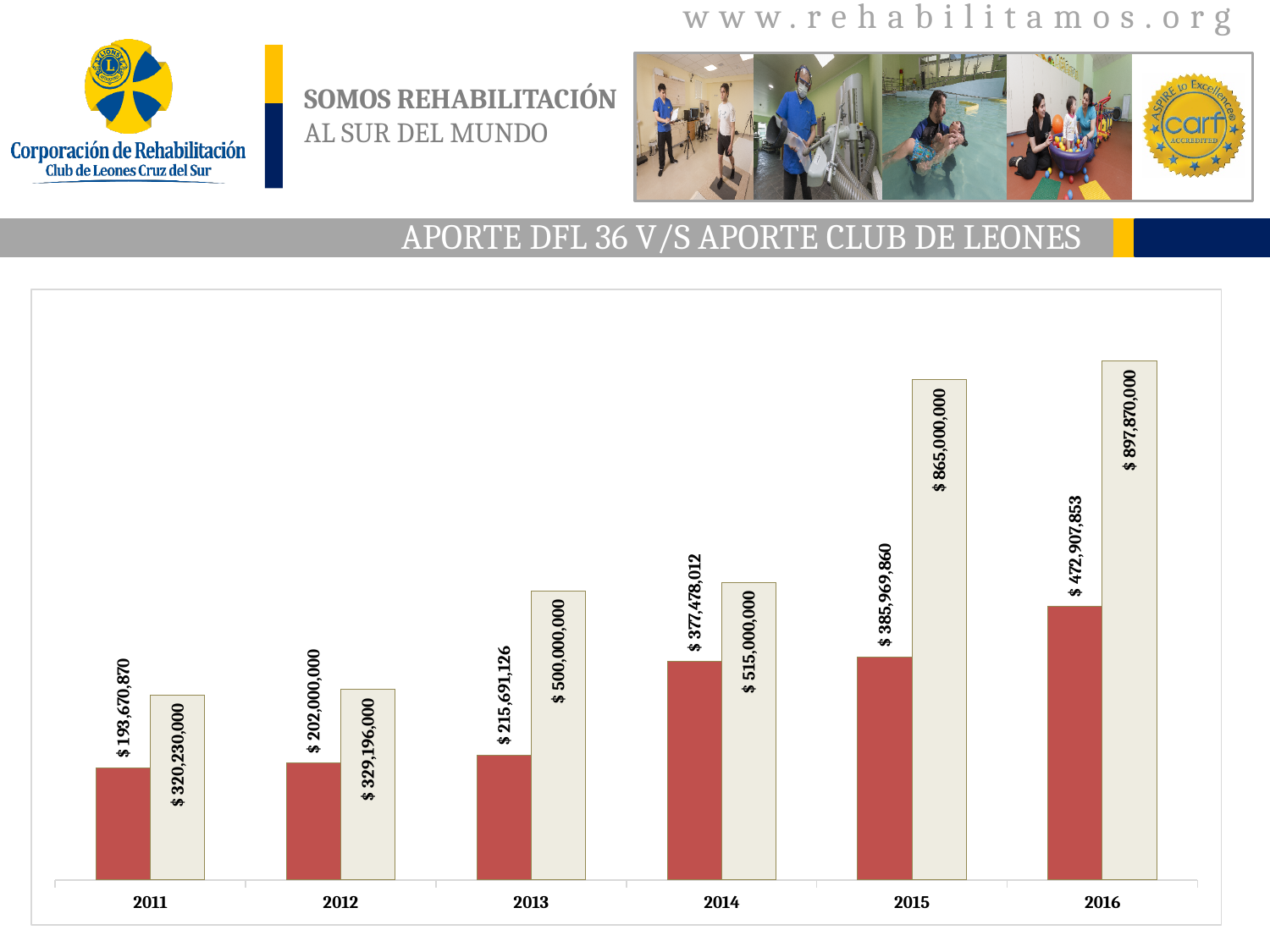
What is the value of the beige bar for 2013? $ 500,000,000 What is the value of the beige bar for 2015? $ 865,000,000 In which year is the red bar the lowest? 2011 How many years are shown on the x axis? 6 What is the value of the red bar for 2016? $ 472,907,853 In which year is the beige bar the highest? 2016 What is the value of the red bar for 2011? $ 193,670,870 What is the difference between the beige bar and the red bar in 2011? $ 126,559,130 Which is larger: the beige bar for 2015 or the beige bar for 2016? 2016 What is the difference between the beige bar and the red bar in 2016? $ 424,962,147 Do the beige bar values rise or fall from 2011 to 2016? Rise What kind of chart is shown on the slide? Bar chart